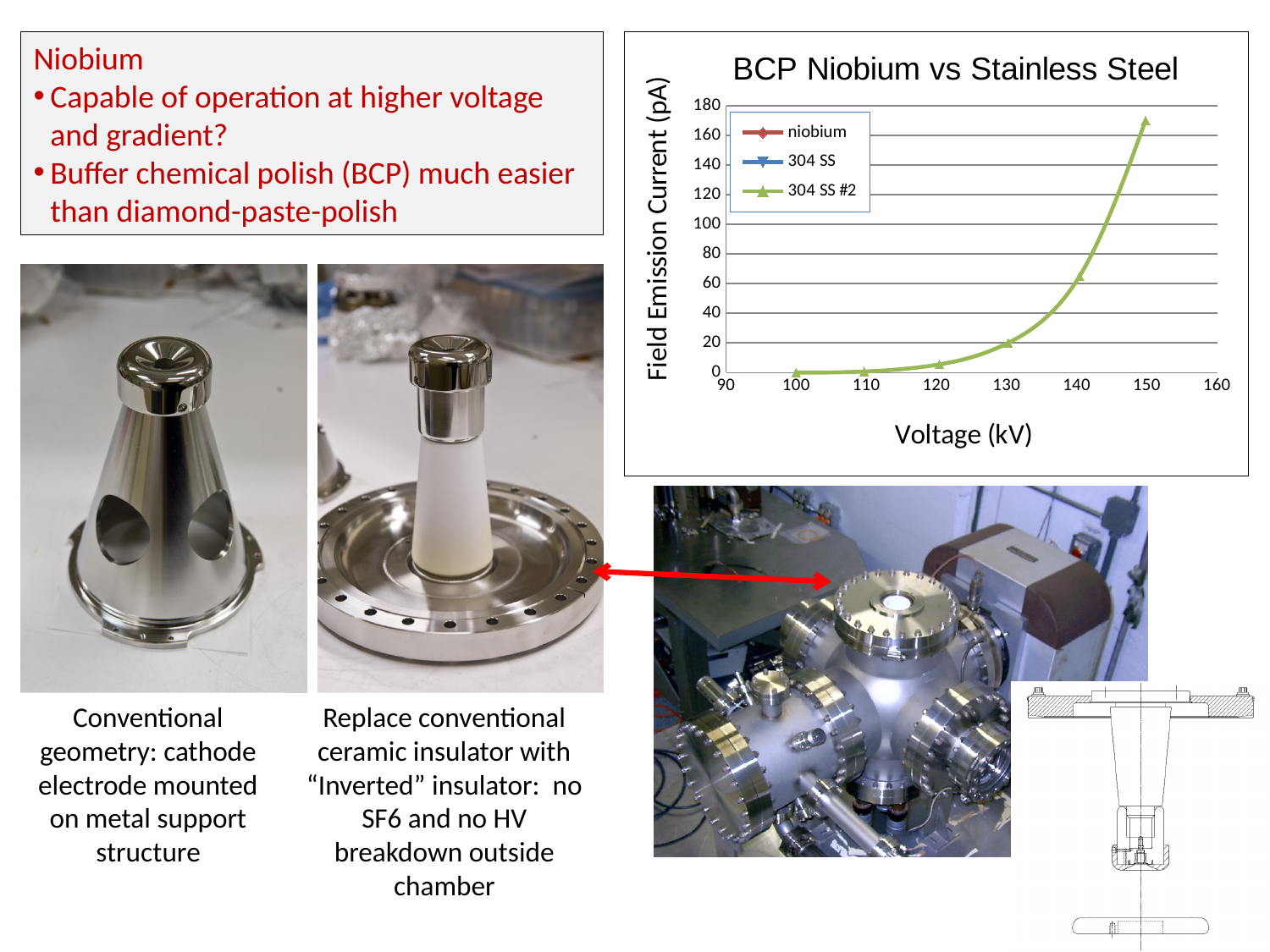
How many data points are plotted for the 304 SS #2 series? 6 Which is larger for 304 SS #2: the field emission current at 140 kV or at 130 kV? 140 kV What is the label of the chart's x axis? Voltage (kV) How many series does the chart's legend list? 3 Is the field emission current for 304 SS #2 at 140 kV greater or less than 40 pA? greater What is the title of the chart? BCP Niobium vs Stainless Steel Does the field emission current for 304 SS #2 rise or fall as voltage increases? rise Is the field emission current for 304 SS #2 at 150 kV greater or less than 160 pA? greater At which plotted voltage is the field emission current for 304 SS #2 highest? 150 kV Is the field emission current for 304 SS #2 at 130 kV greater or less than 40 pA? less What kind of chart is shown on the slide? line chart